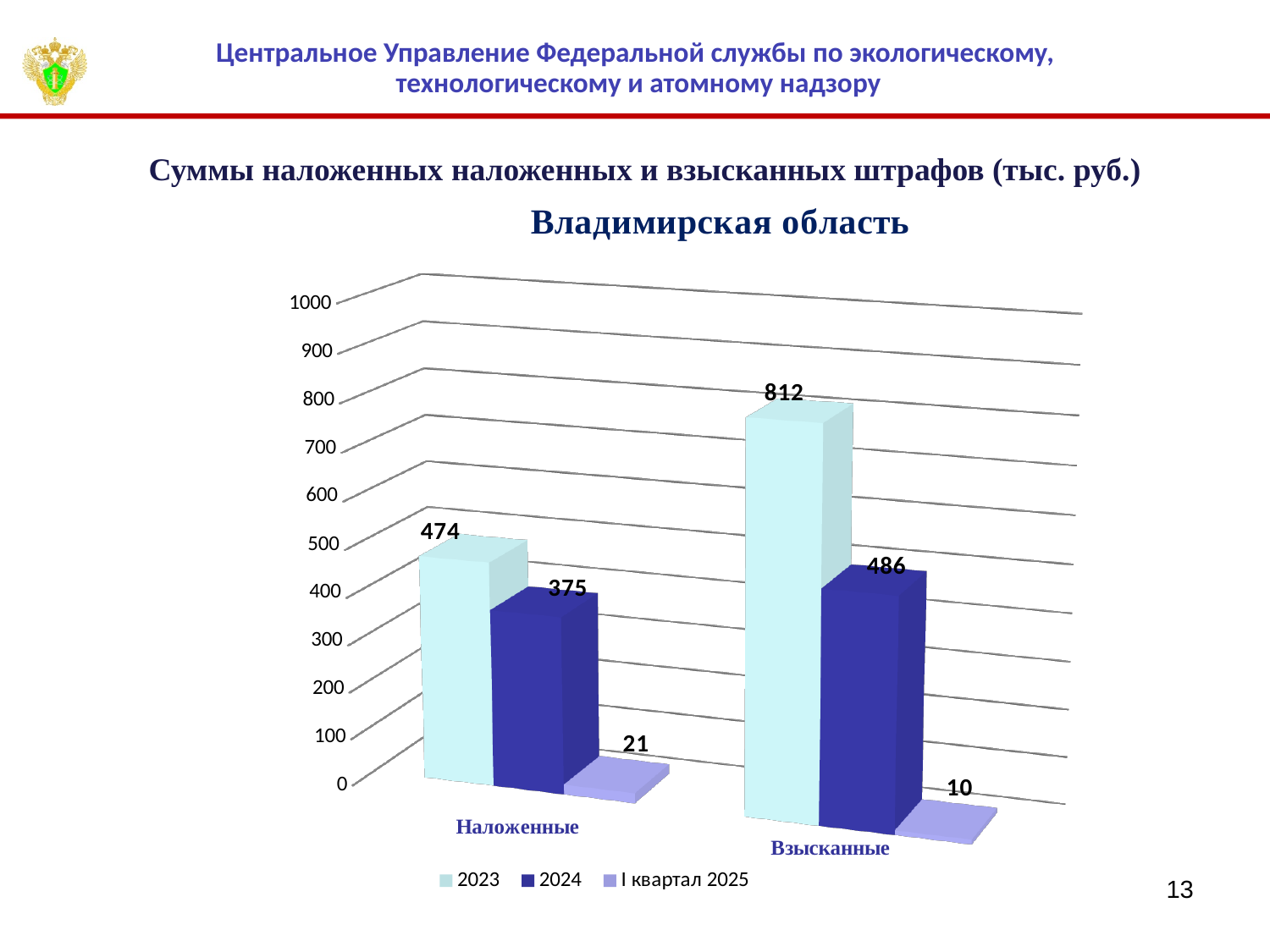
What is the value for 2023 in the Наложенные category? 474 Which series has the highest value in the Взысканные category? 2023 What kind of chart is shown on the slide? bar chart Which series has the lowest value in the Наложенные category? I квартал 2025 How many categories are shown on the x axis? 2 What is the value for I квартал 2025 in the Взысканные category? 10 What is the difference between the 2023 values for Взысканные and Наложенные? 338 What is the value for I квартал 2025 in the Наложенные category? 21 What is the value for 2024 in the Взысканные category? 486 How many series does the legend list? 3 Which is larger: the 2024 value for Наложенные or the 2024 value for Взысканные? Взысканные What is the difference between the 2023 and 2024 values in the Наложенные category? 99